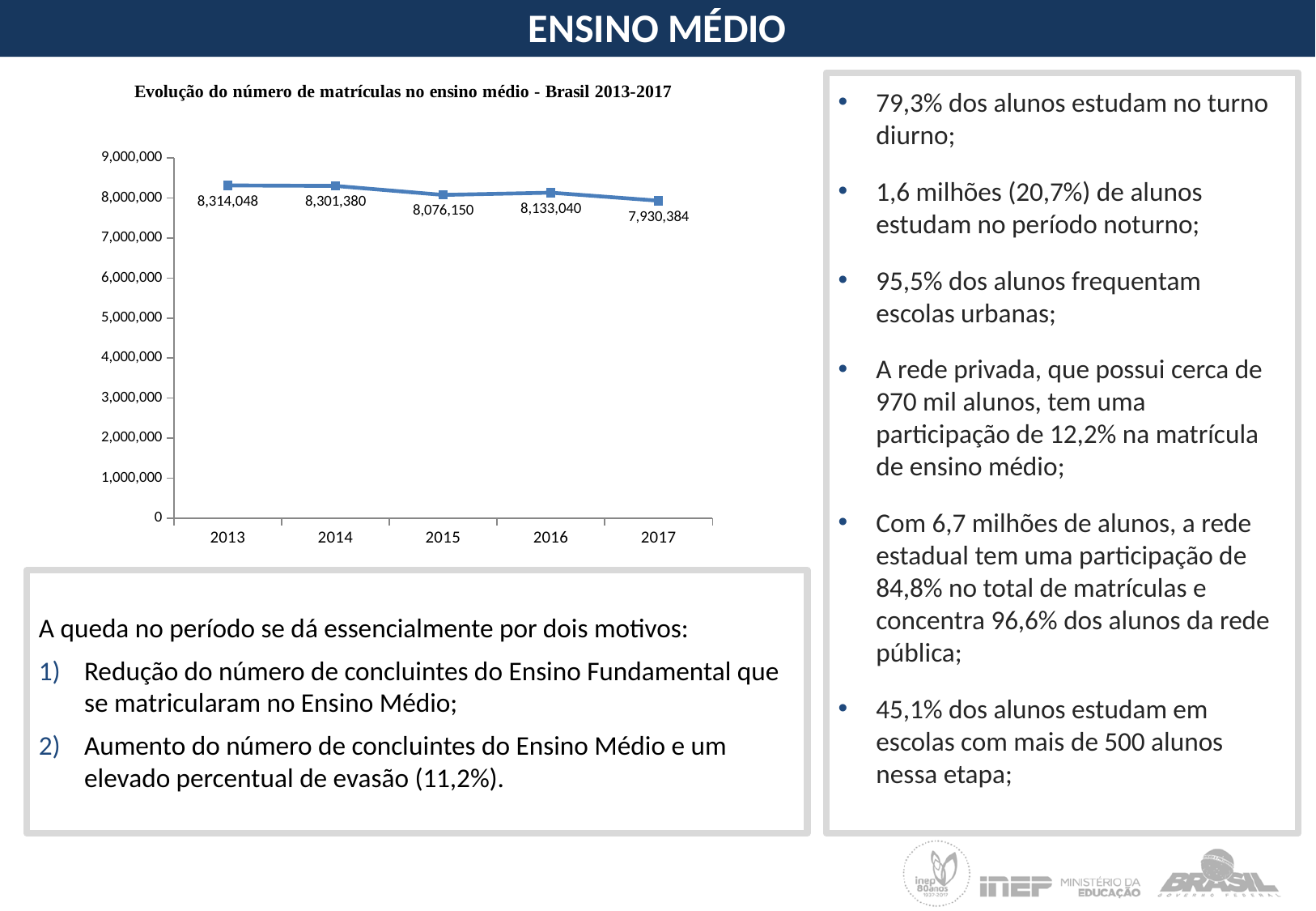
Which year has the lowest number of enrolments? 2017 Is the value for 2017 greater or less than 8,000,000? less Which is larger, the value for 2016 or the value for 2015? 2016 What is the value for 2015? 8,076,150 What is the difference between the 2016 value and the 2015 value? 56,890 What is the number of enrolments shown for 2013? 8,314,048 How many years are plotted on the chart? 5 What kind of chart is shown on the slide? line chart What value is plotted for 2017? 7,930,384 Which year has the highest number of enrolments? 2013 Overall, do the values rise or fall from 2013 to 2017? fall What is the difference between the 2013 value and the 2017 value? 383,664